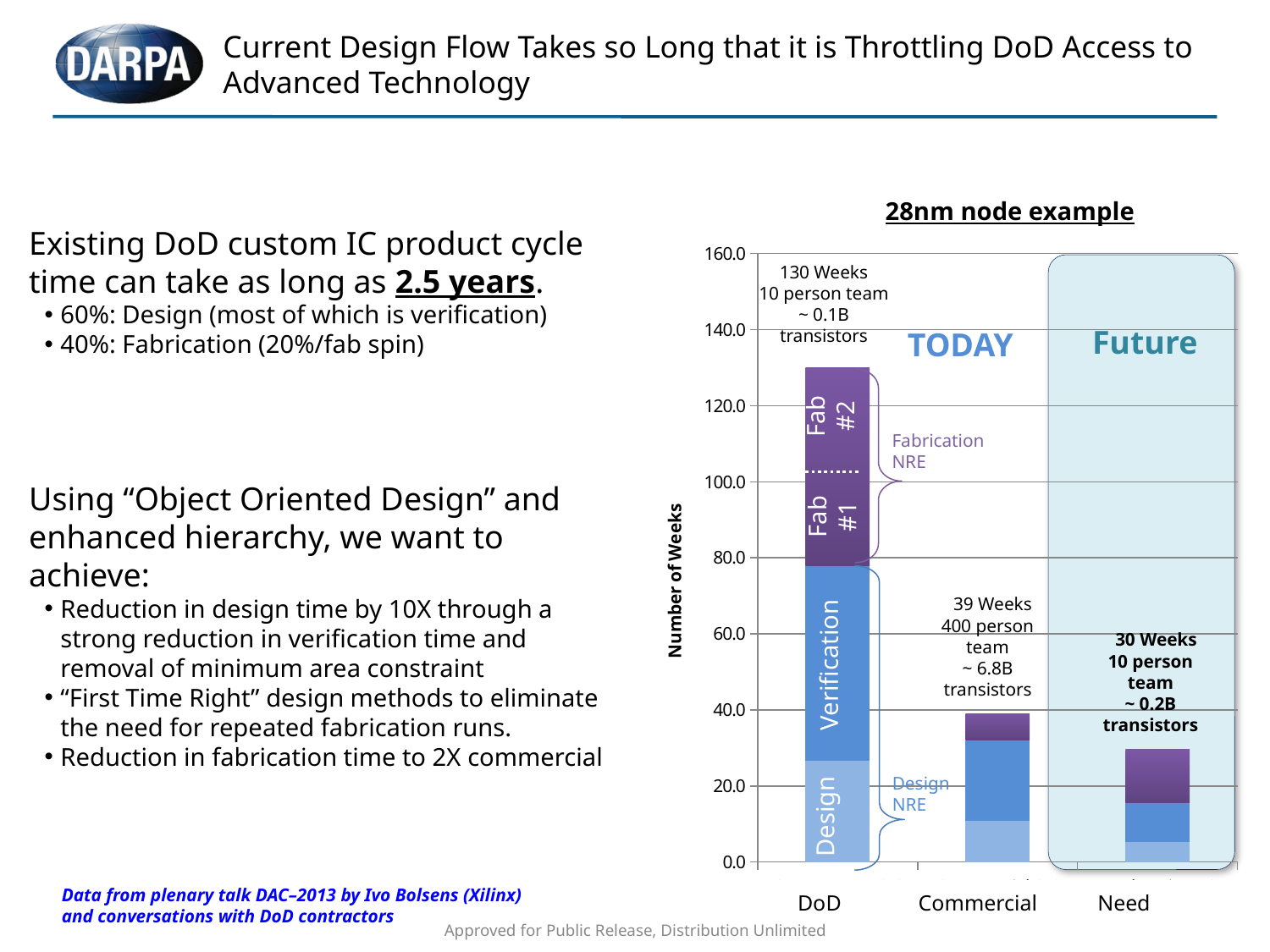
What kind of chart is shown on the slide? stacked bar chart Is the total for the DoD bar greater or less than 120? greater How many weeks does the Need bar represent according to its annotation? 30 Weeks What is the title of the chart? 28nm node example What is the label of the vertical axis? Number of Weeks Which category has the tallest bar? DoD How many categories are shown on the x axis? 3 What is the difference in weeks between the DoD bar and the Commercial bar? 91 Weeks Which category has the shortest bar? Need Do the bar totals rise or fall from DoD to Need along the x axis? fall How many weeks does the Commercial bar represent according to its annotation? 39 Weeks How many weeks does the DoD bar represent according to its annotation? 130 Weeks